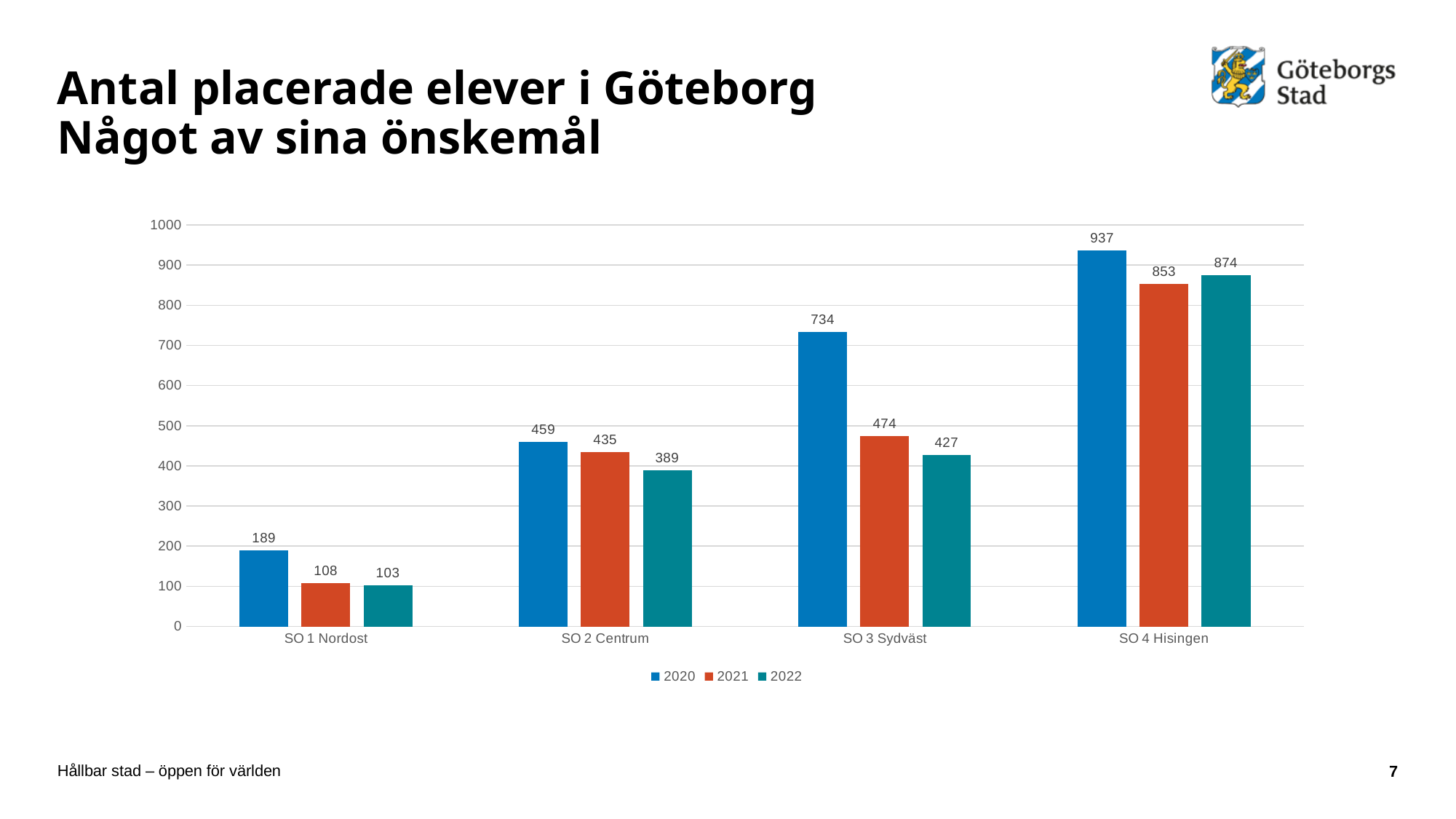
What is the value for SO 3 Sydväst in 2021? 474 What is the value for SO 1 Nordost in 2022? 103 Which series is shown in blue in the legend? 2020 What kind of chart is shown on the slide? bar chart Which category has the highest value in 2022? SO 4 Hisingen How many series does the legend list? 3 Which is larger for SO 4 Hisingen: the 2021 value or the 2022 value? 2022 Which category has the lowest value in 2020? SO 1 Nordost What is the difference between the 2020 and 2022 values for SO 3 Sydväst? 307 How many categories are shown on the x axis? 4 Is the value for SO 2 Centrum in 2020 greater or less than 400? greater What is the value for SO 4 Hisingen in 2020? 937